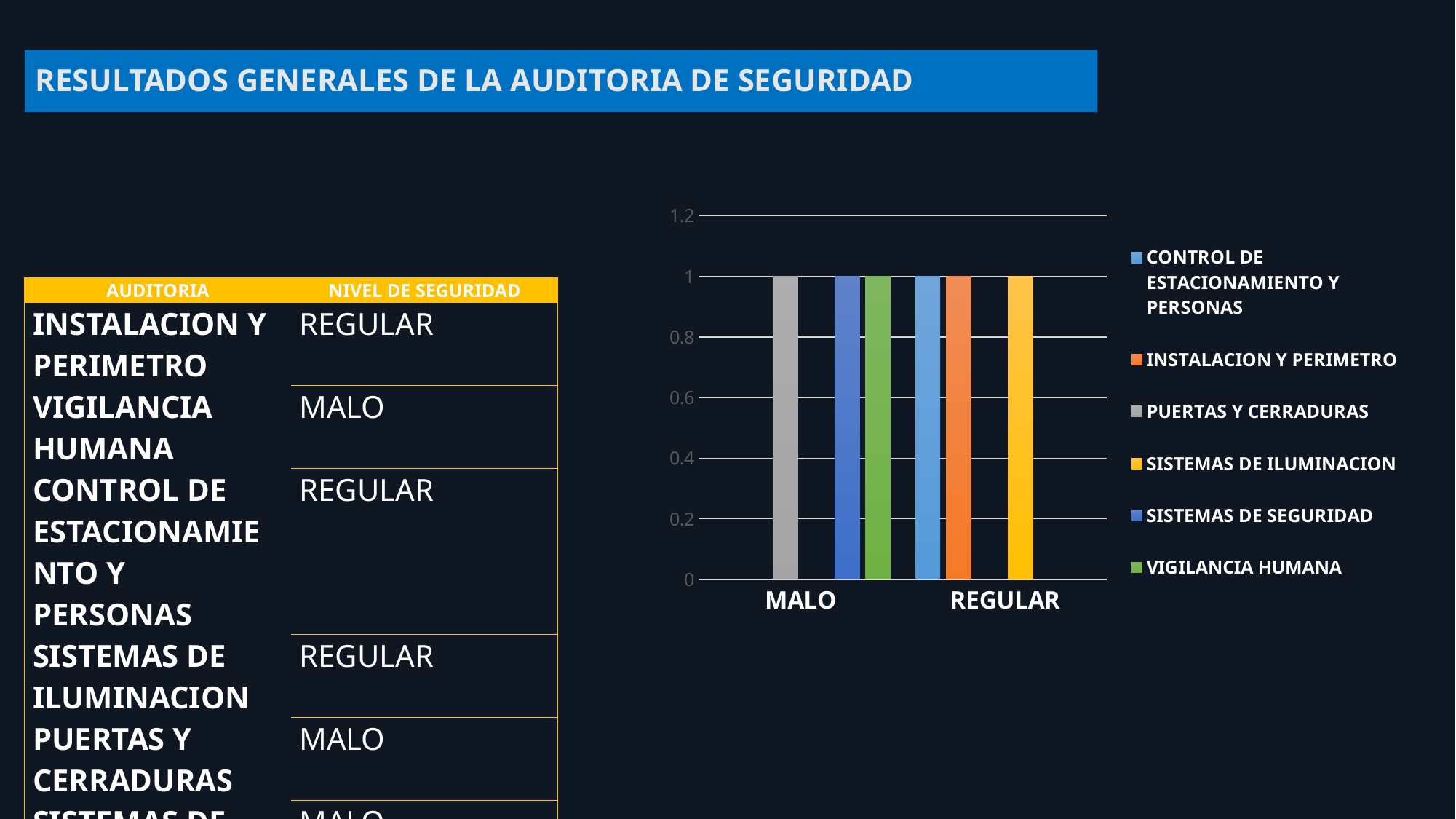
What is the highest value shown on the chart's y axis? 1.2 How many categories are shown on the x axis of the chart? 2 Is the value of the SISTEMAS DE SEGURIDAD bar in the MALO category greater or less than 1.2? less How many bars appear in the MALO category? 3 What is the value of the PUERTAS Y CERRADURAS bar in the MALO category? 1 What is the value of the SISTEMAS DE ILUMINACION bar in the REGULAR category? 1 Is the value of the INSTALACION Y PERIMETRO bar in the REGULAR category greater or less than 0.8? greater What kind of chart is shown on the slide? bar chart Which series is shown in orange in the chart legend? INSTALACION Y PERIMETRO What is the value of the VIGILANCIA HUMANA bar in the MALO category? 1 How many series does the chart legend list? 6 What is the difference between the PUERTAS Y CERRADURAS bar in MALO and the CONTROL DE ESTACIONAMIENTO Y PERSONAS bar in REGULAR? 0